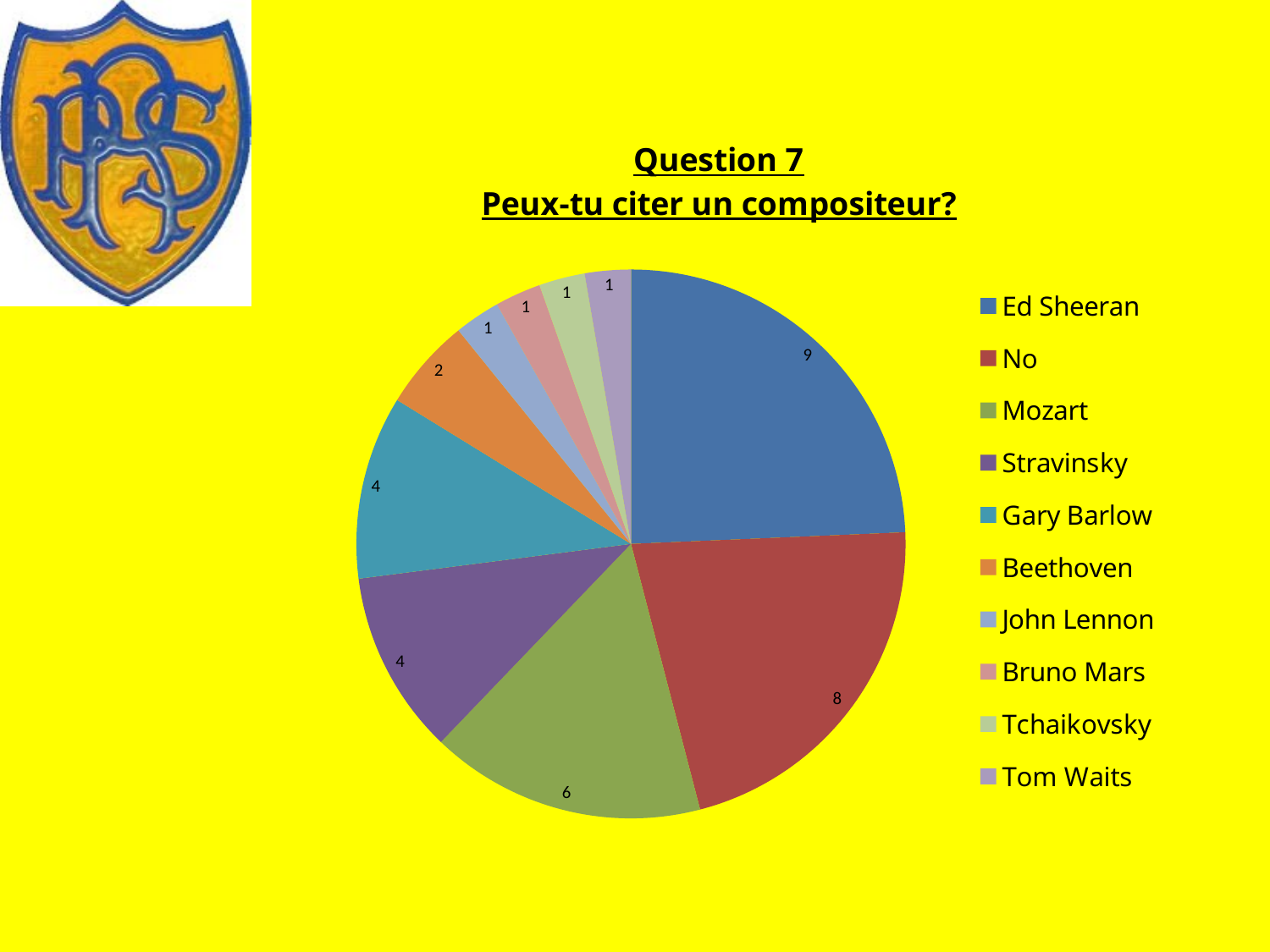
What value is shown for the 'No' slice in the pie chart? 8 What is the difference between the values for Ed Sheeran and 'No'? 1 Which category has the largest slice in the pie chart? Ed Sheeran What is the difference between the values for Mozart and Beethoven? 4 What value is shown for Gary Barlow in the pie chart? 4 What kind of chart is shown on the slide? Pie chart What value is shown for Mozart in the pie chart? 6 What is the total of all the values shown in the pie chart? 37 How many categories does the legend of the pie chart list? 10 What value is shown for Ed Sheeran in the pie chart? 9 Which is larger, the value for Mozart or the value for Stravinsky? Mozart What value is shown for Beethoven in the pie chart? 2